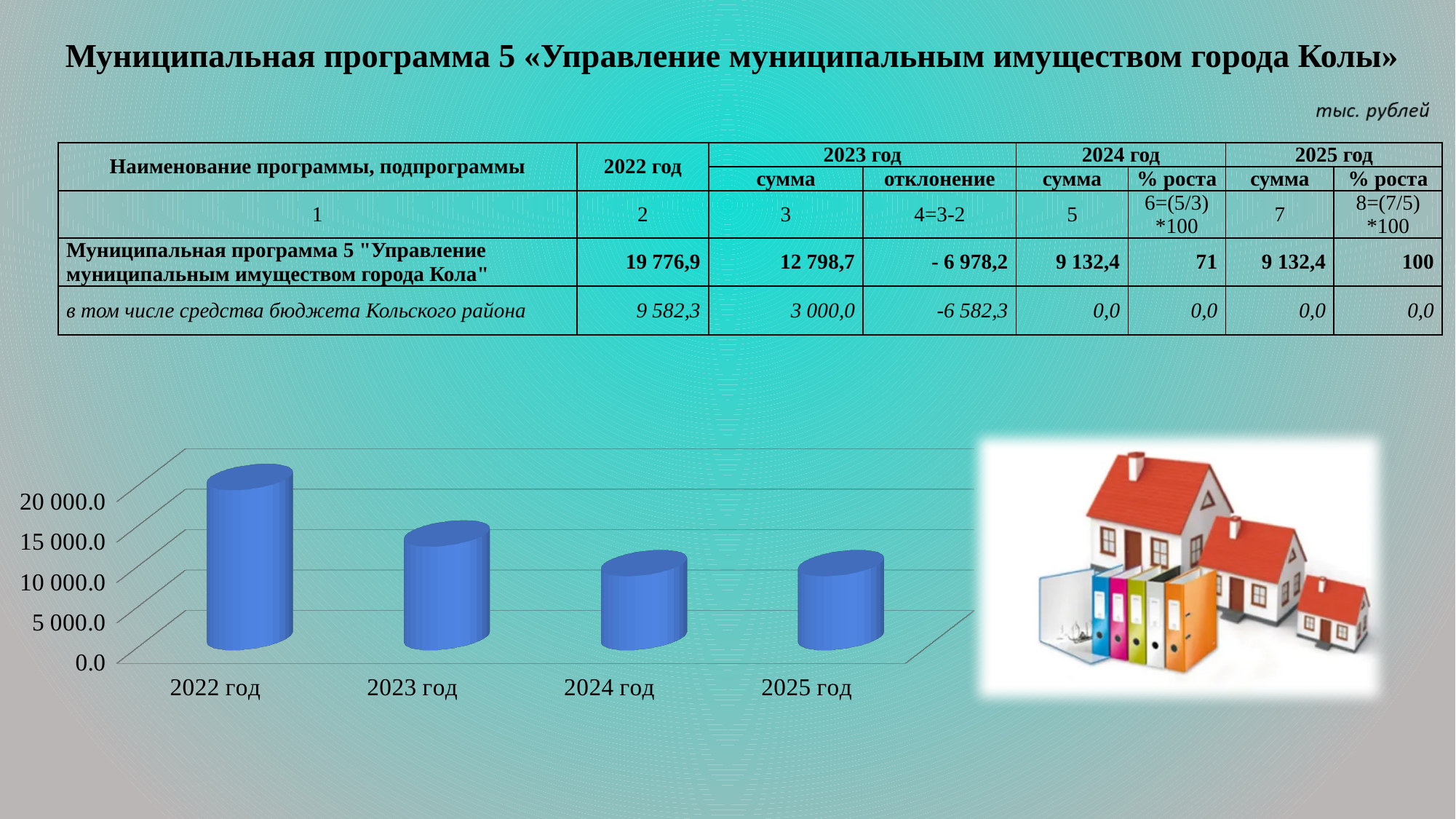
Is the value for 2025 год on the chart greater or less than 15 000.0? less Is the value for 2023 год on the chart greater or less than 10 000.0? greater Which year has the highest bar on the chart? 2022 год Is the value for 2023 год on the chart greater or less than 15 000.0? less What kind of chart is shown on the slide? bar chart Which is larger on the chart, the value for 2023 год or the value for 2024 год? 2023 год Do the values on the chart generally rise or fall from 2022 год to 2025 год? fall What is the highest tick label shown on the chart's vertical axis? 20 000.0 Which is larger on the chart, the value for 2022 год or the value for 2023 год? 2022 год How many categories (years) are plotted on the chart? 4